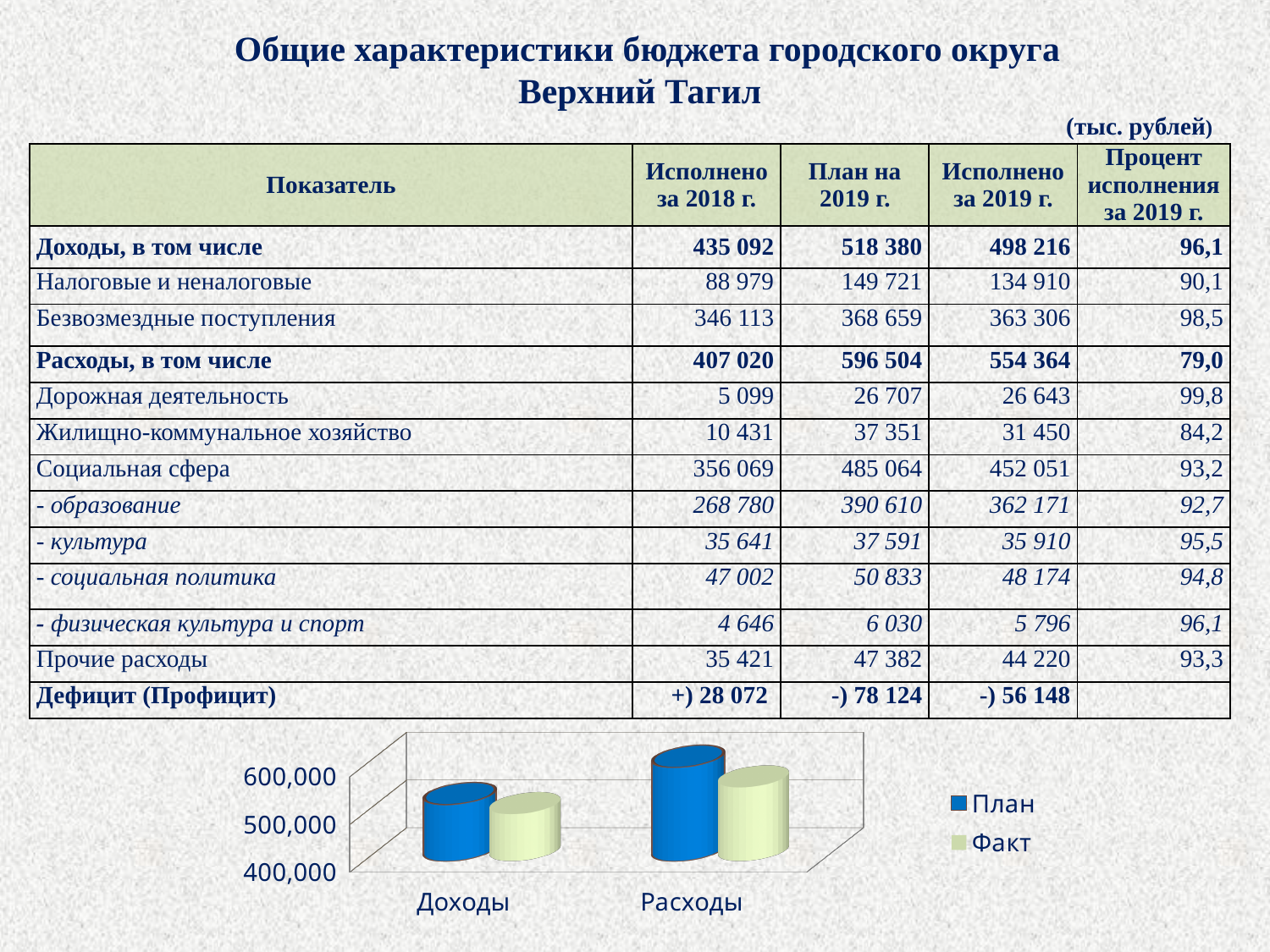
How many series does the chart legend list? 2 Is the Факт value for Расходы in the chart greater or less than 500,000? greater In the chart, for Расходы, which is larger: План or Факт? План Which bar in the chart is the lowest? Факт for Доходы In the chart, is the План bar for Расходы larger or smaller than the План bar for Доходы? larger What kind of chart is shown at the bottom of the slide? bar chart What are the two series named in the chart legend? План, Факт Which category has the tallest bar in the chart? Расходы Which colour represents the План series in the chart? blue Is the План value for Доходы in the chart greater or less than 600,000? less In the chart, for Доходы, which is larger: План or Факт? План How many categories are shown on the x axis of the chart? 2